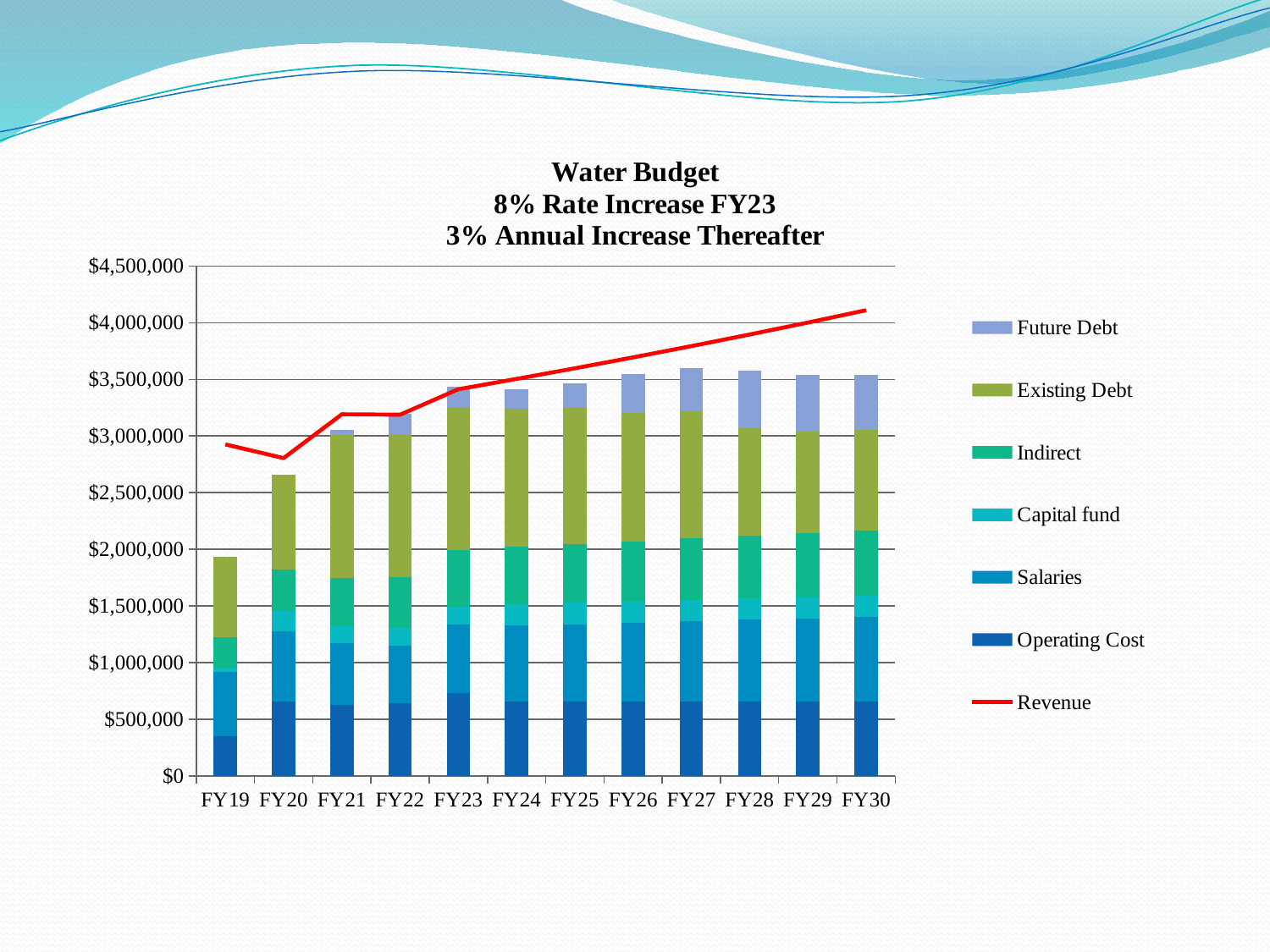
What kind of chart is shown on the slide? Stacked bar chart with a line What colour is the Revenue line? Red How many series does the legend list? 7 Does the Revenue line generally rise or fall from FY19 to FY30? rise Is the Operating Cost value for FY19 greater or less than $500,000? less Which fiscal year has the lowest total stacked bar? FY19 Is the total stacked bar for FY20 greater or less than $2,500,000? greater Is the Revenue value for FY30 greater or less than $4,000,000? greater Which is larger, the total stacked bar for FY19 or for FY20? FY20 How many fiscal years are shown on the x axis? 12